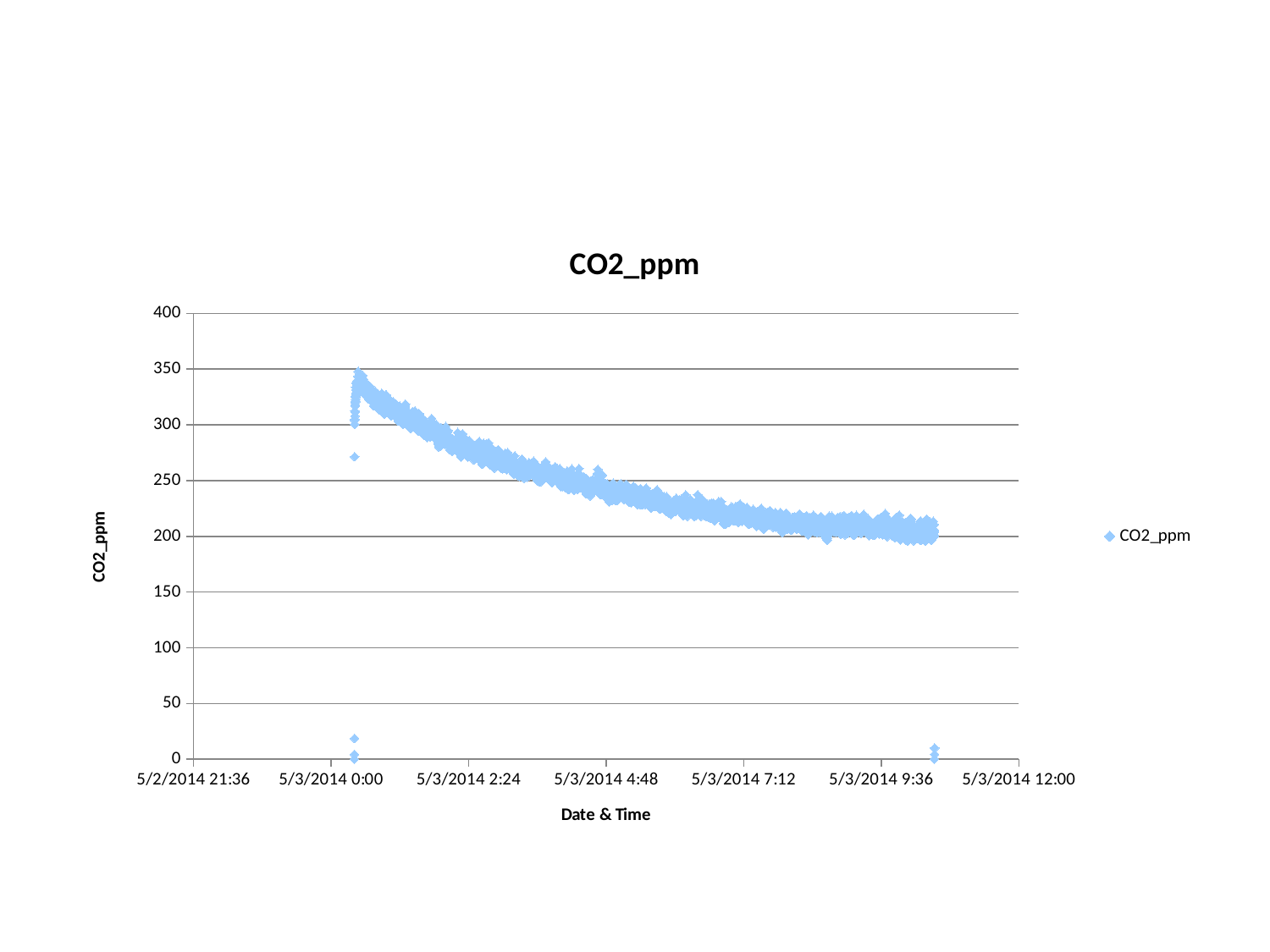
Which is larger, the CO2_ppm value at 5/3/2014 2:24 or at 5/3/2014 7:12? 5/3/2014 2:24 Is the CO2_ppm value at 5/3/2014 9:36 greater or less than 250? less Is the CO2_ppm value at 5/3/2014 7:12 greater or less than 250? less Is the CO2_ppm value at 5/3/2014 2:24 greater or less than 250? greater Do the CO2_ppm values generally rise or fall from 5/3/2014 0:00 to 5/3/2014 9:36? fall What is the label of the x axis? Date & Time What kind of chart is shown on the slide? scatter chart How many series does the legend list? 1 What is the title of the chart? CO2_ppm